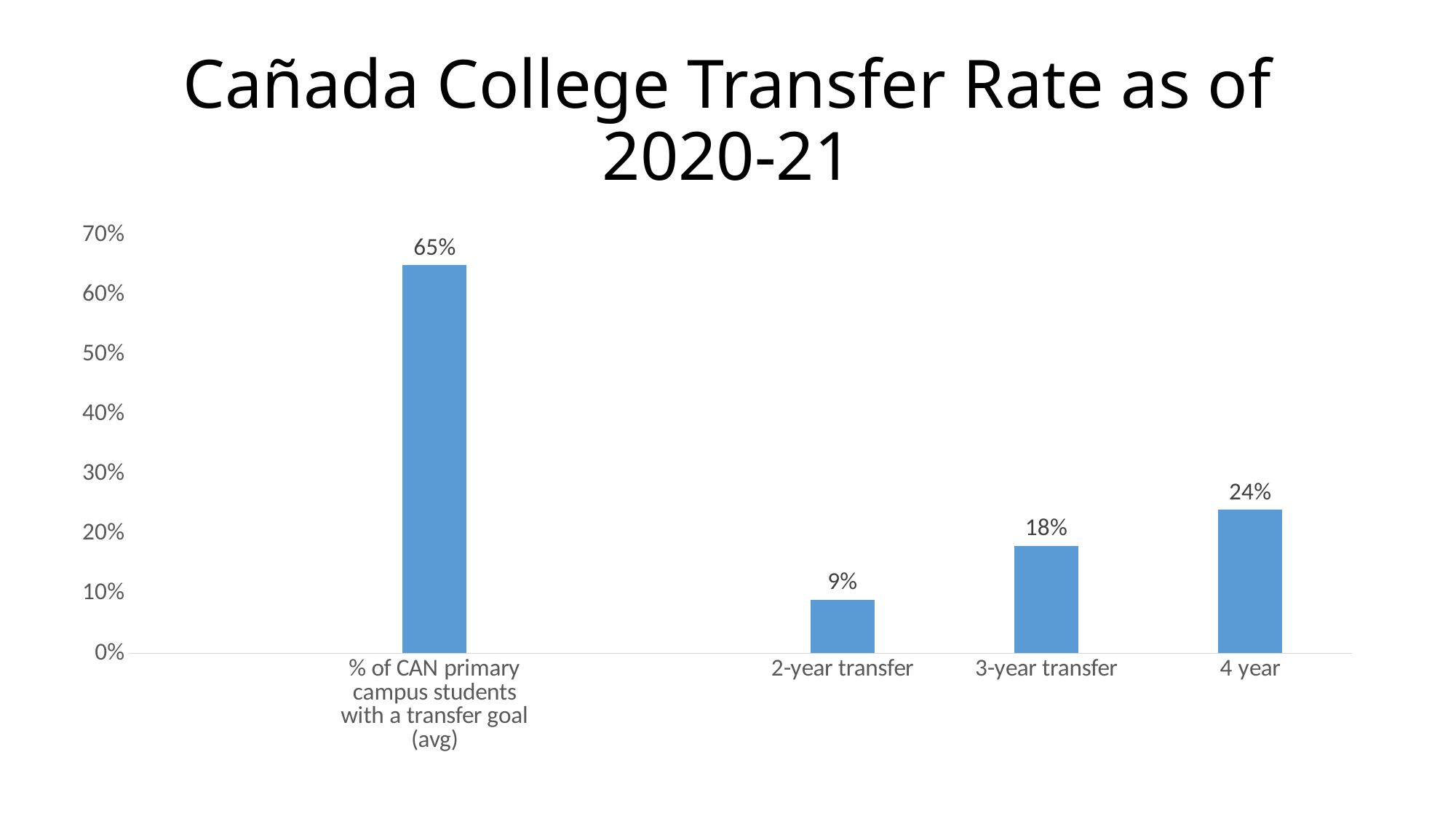
What is the difference between the 3-year transfer value and the 2-year transfer value? 9% What is the value for 3-year transfer? 18% Which category has the highest value? % of CAN primary campus students with a transfer goal (avg) What is the difference between the 4 year value and the 2-year transfer value? 15% What is the title of the chart? Cañada College Transfer Rate as of 2020-21 Which category has the lowest value? 2-year transfer What is the value for 2-year transfer? 9% What is the value for % of CAN primary campus students with a transfer goal (avg)? 65% What kind of chart is shown on the slide? Bar chart What is the value for 4 year? 24% Which is larger, the value for 3-year transfer or the value for 4 year? 4 year How many bars are plotted in the chart? 4